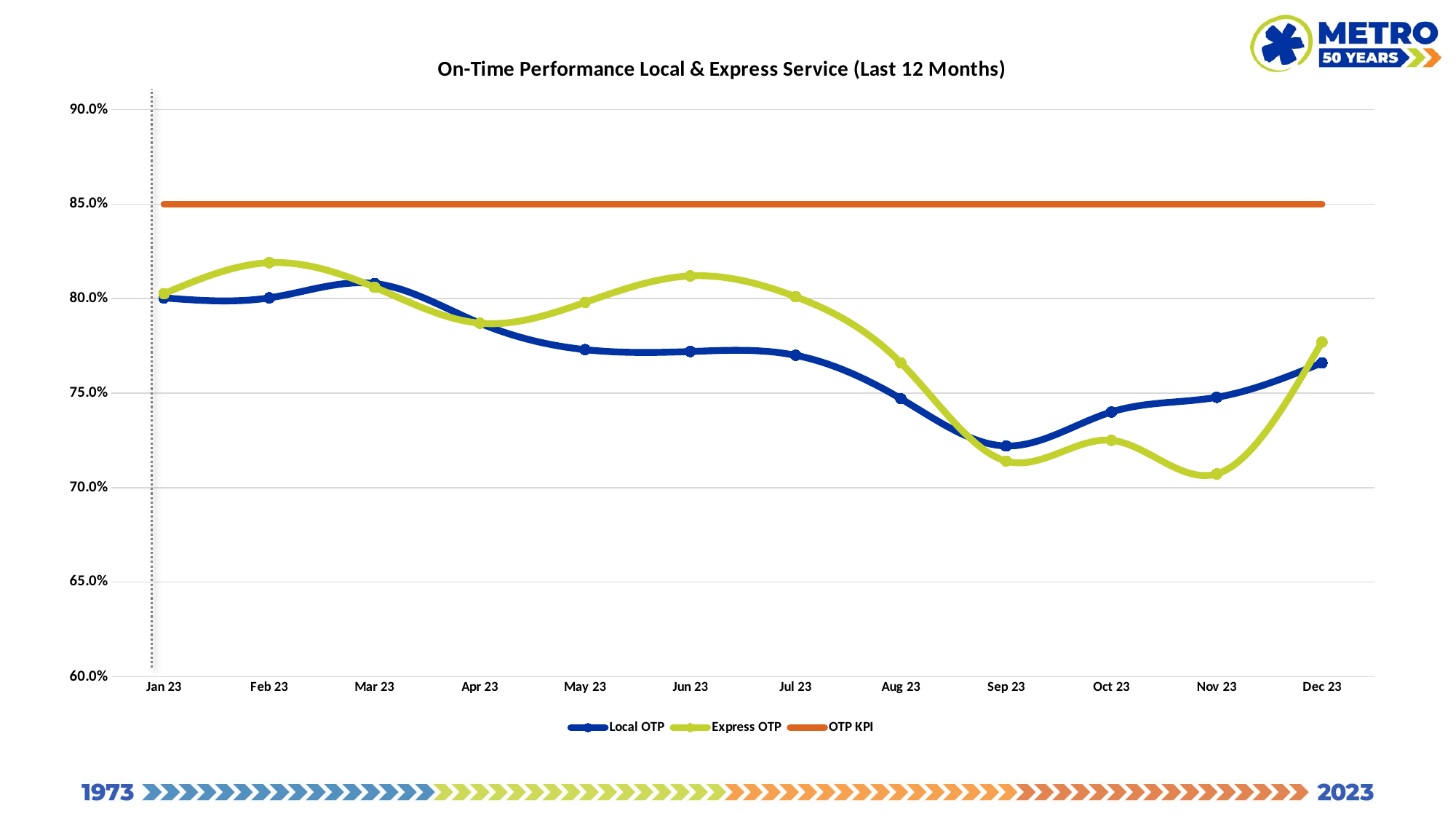
Does Local OTP rise or fall from Sep 23 to Dec 23? Rises What is the title of the chart? On-Time Performance Local & Express Service (Last 12 Months) In Nov 23, which is higher: Local OTP or Express OTP? Local OTP What value does the OTP KPI line sit at? 85.0% How many months are plotted along the x axis? 12 What type of chart is shown on the slide? Line chart Is the Express OTP value for Nov 23 greater or less than 75.0%? less In which month is Local OTP at its lowest? Sep 23 In Jun 23, which is higher: Local OTP or Express OTP? Express OTP Is the Express OTP value for Feb 23 greater or less than 80.0%? greater How many series does the legend list? 3 Is the Local OTP value for Sep 23 greater or less than 75.0%? less